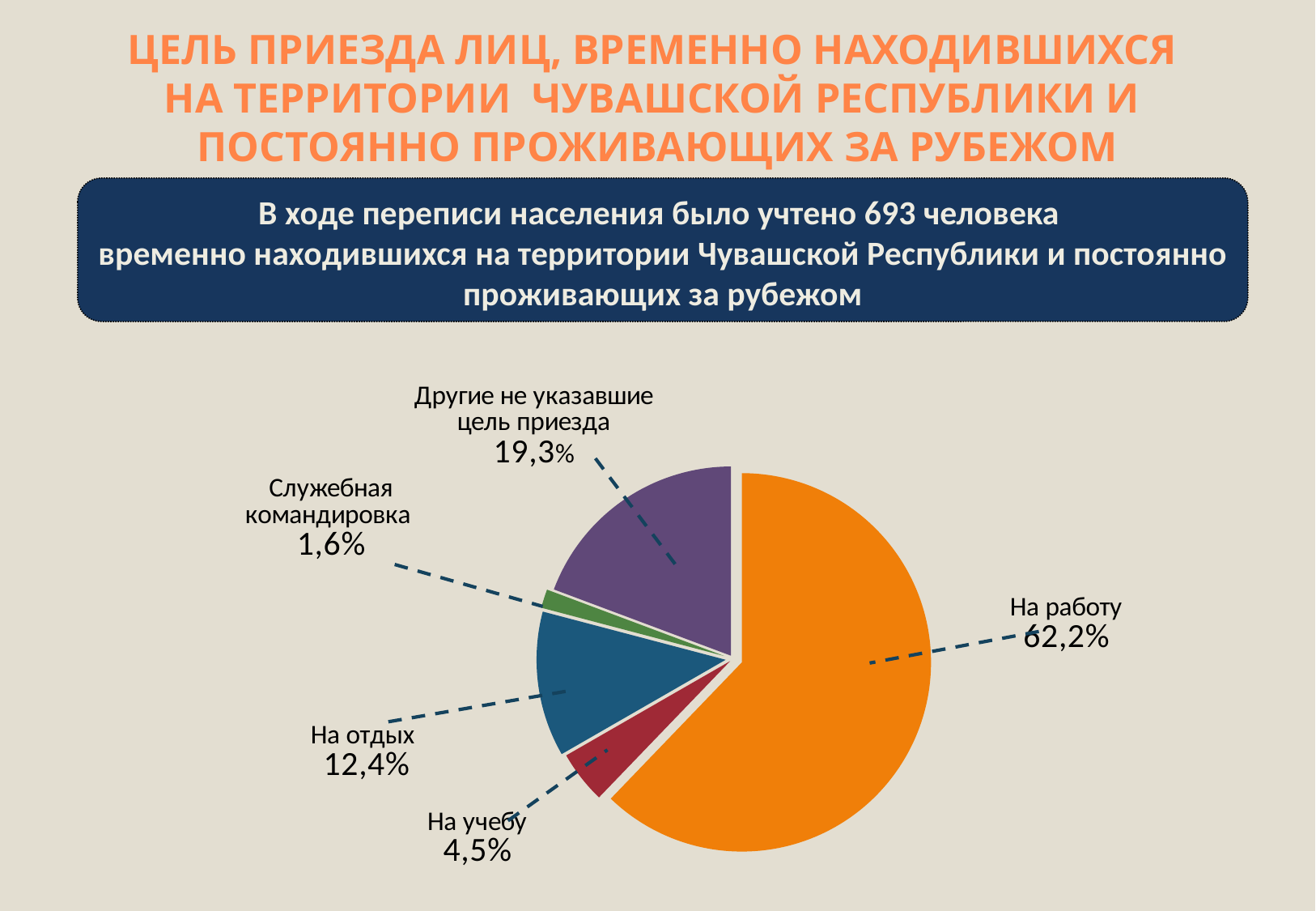
What is the value shown for "На учебу"? 4,5% What kind of chart is shown on the slide? Pie chart What is the value shown for "На отдых"? 12,4% How many categories are shown in the pie chart? 5 Which category has the largest slice of the pie? На работу What share of the pie does "На работу" account for? 62,2% What is the value shown for "Служебная командировка"? 1,6% Which is larger, the share for "На отдых" or the share for "На учебу"? На отдых What share of the pie is labelled "Другие не указавшие цель приезда"? 19,3% What is the difference in percentage points between "На работу" and "Другие не указавшие цель приезда"? 42,9 Which category has the smallest slice of the pie? Служебная командировка What is the difference in percentage points between "На отдых" and "На учебу"? 7,9